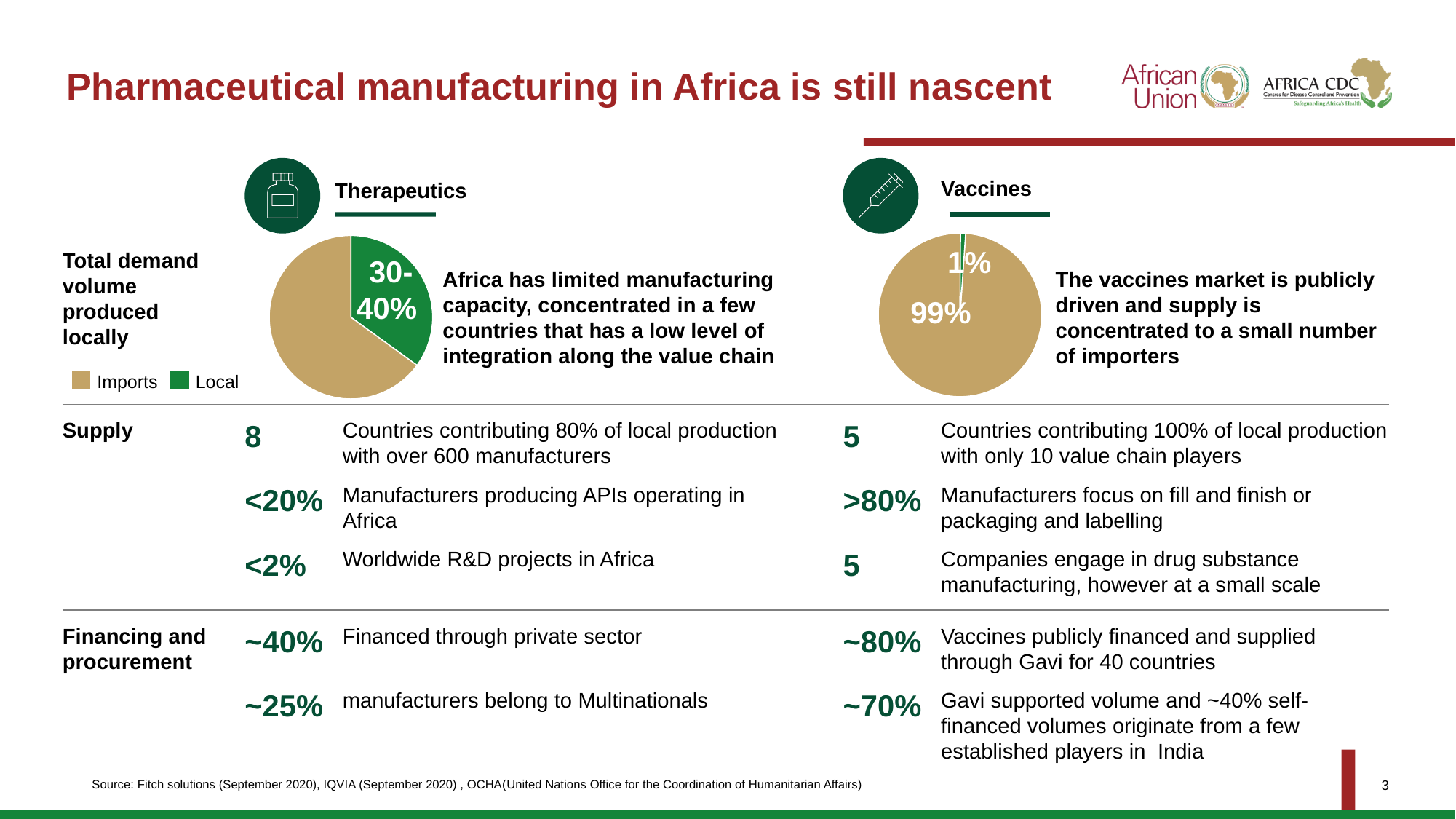
Is the Local share larger in the Therapeutics pie chart or the Vaccines pie chart? Therapeutics What kind of chart is the Therapeutics chart on the left? Pie chart In the Vaccines pie chart, what is the difference between the Imports share and the Local share? 98 percentage points How many categories does the legend for the pie charts list? 2 In the Therapeutics pie chart, what share is labelled for the Local slice? 30-40% In the Therapeutics pie chart, which slice is the largest? Imports In the Vaccines pie chart, which slice is the smallest? Local In the pie charts, which colour represents Imports? Tan (gold) In the Vaccines pie chart, what share is labelled for Imports? 99% In the Vaccines pie chart, what share is labelled for Local? 1% In the pie charts, which colour represents Local? Green In the Therapeutics pie chart, which is larger, Imports or Local? Imports